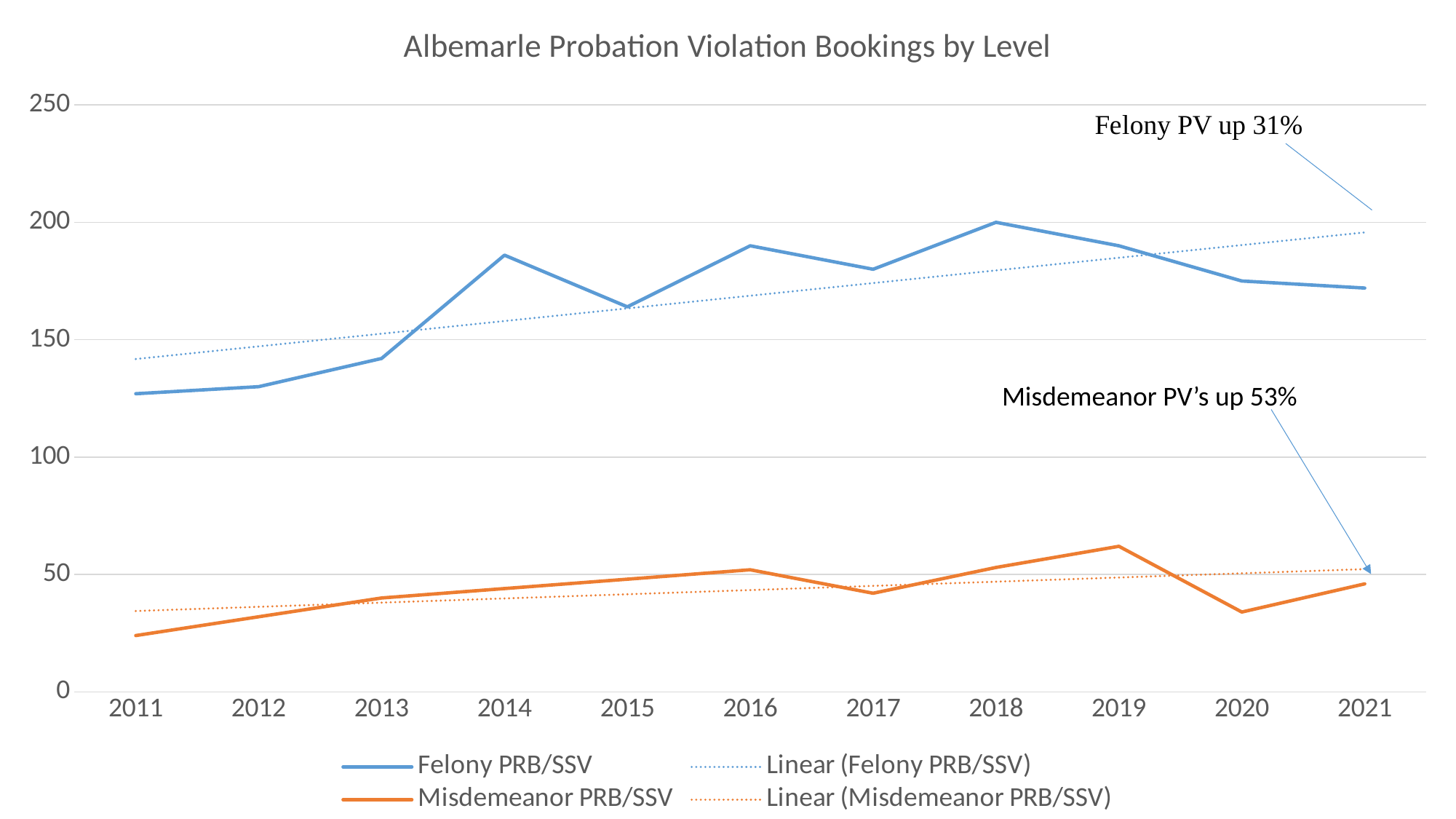
How many years are shown on the x axis? 11 In which year does the Felony PRB/SSV line reach its highest value? 2018 In which year does the Misdemeanor PRB/SSV line reach its highest value? 2019 How many entries does the legend list? 4 What type of chart is shown on the slide? line chart In which year does the Felony PRB/SSV line have its lowest value? 2011 What is the title of the chart? Albemarle Probation Violation Bookings by Level Is the Felony PRB/SSV value for 2014 greater or less than 150? greater Is the Misdemeanor PRB/SSV value for 2020 greater or less than 50? less In which year does the Misdemeanor PRB/SSV line have its lowest value? 2011 Which series is higher in 2016, Felony PRB/SSV or Misdemeanor PRB/SSV? Felony PRB/SSV According to the annotation on the chart, by what percentage are Misdemeanor PV's up? 53%